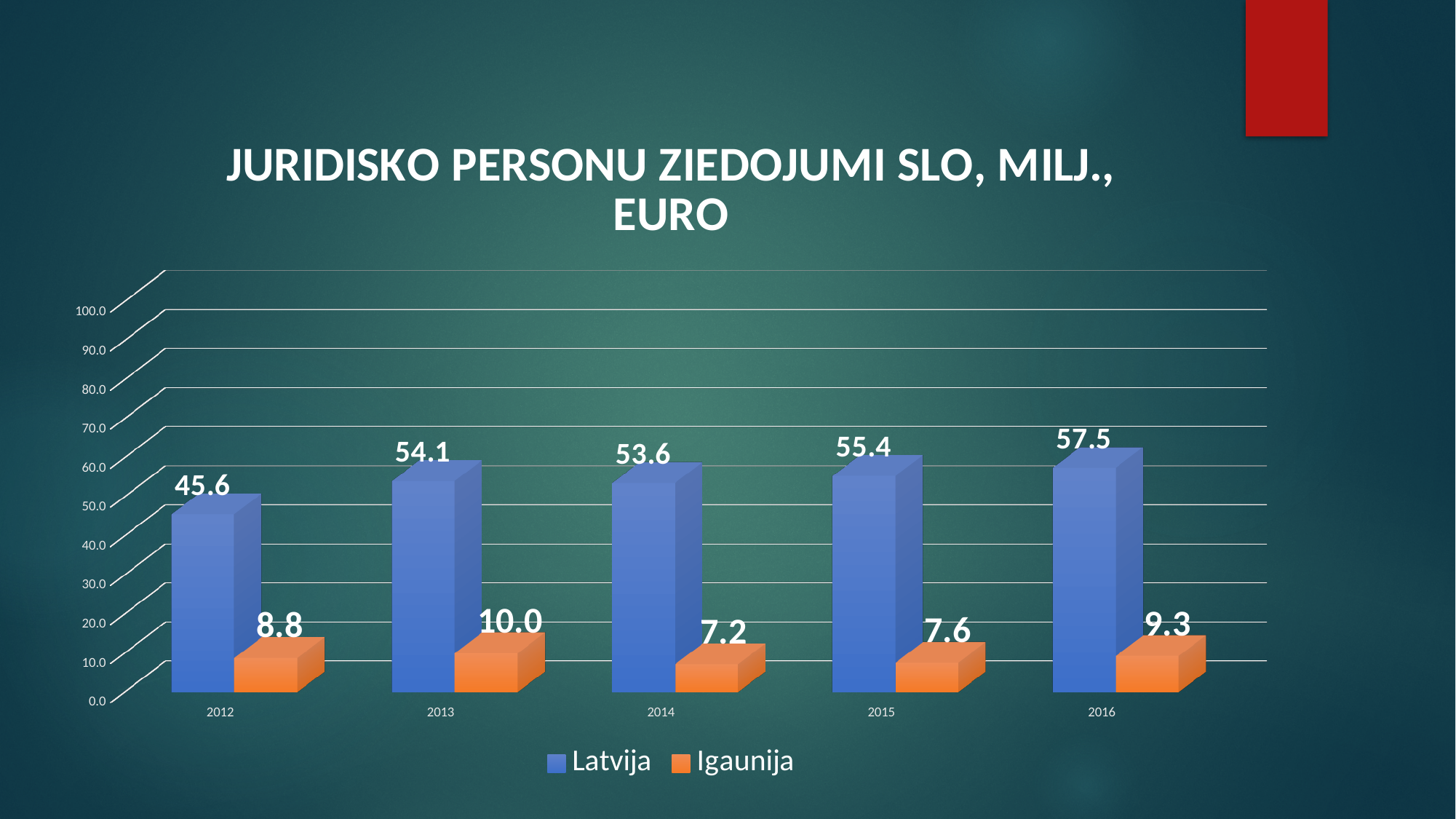
What kind of chart is shown on the slide? bar chart How many series does the legend list? 2 What is the value for Latvija in 2012? 45.6 Is the value for Latvija in 2014 greater or less than 50.0? greater How many years are shown on the x axis? 5 Which is larger, the Igaunija value in 2012 or in 2016? 2016 What is the value for Latvija in 2016? 57.5 In which year is the Latvija value highest? 2016 What is the difference between the Latvija and Igaunija values in 2015? 47.8 Which series is shown in orange? Igaunija What is the value for Igaunija in 2013? 10.0 In which year is the Igaunija value lowest? 2014